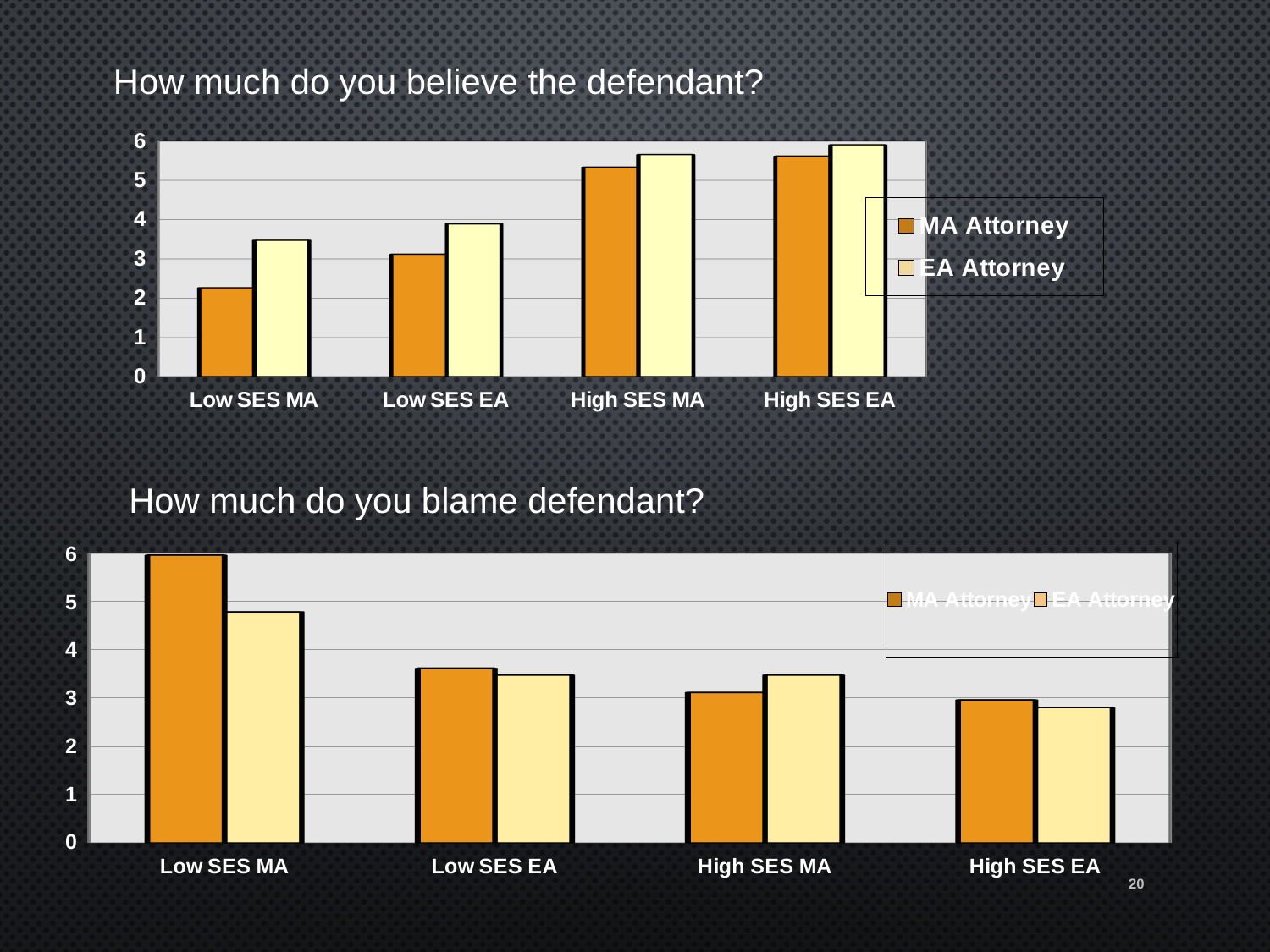
In the 'How much do you believe the defendant?' chart, is the MA Attorney value for Low SES MA greater or less than 3? less In the 'How much do you blame defendant?' chart, for Low SES MA, which series has the larger value, MA Attorney or EA Attorney? MA Attorney How many series does the legend of the 'How much do you believe the defendant?' chart list? 2 In the 'How much do you blame defendant?' chart, do the MA Attorney values rise or fall from Low SES MA to High SES EA? fall In the 'How much do you blame defendant?' chart, which category has the highest MA Attorney value? Low SES MA In the 'How much do you believe the defendant?' chart, for Low SES MA, which series has the larger value, MA Attorney or EA Attorney? EA Attorney In the 'How much do you blame defendant?' chart, is the EA Attorney value for Low SES MA greater or less than 4? greater In the 'How much do you believe the defendant?' chart, do the MA Attorney values rise or fall from Low SES MA to High SES EA? rise What kind of chart is the 'How much do you believe the defendant?' chart? bar chart What are the two legend entries in the 'How much do you blame defendant?' chart? MA Attorney and EA Attorney How many categories are shown on the x axis of the 'How much do you believe the defendant?' chart? 4 In the 'How much do you believe the defendant?' chart, which category has the lowest MA Attorney value? Low SES MA